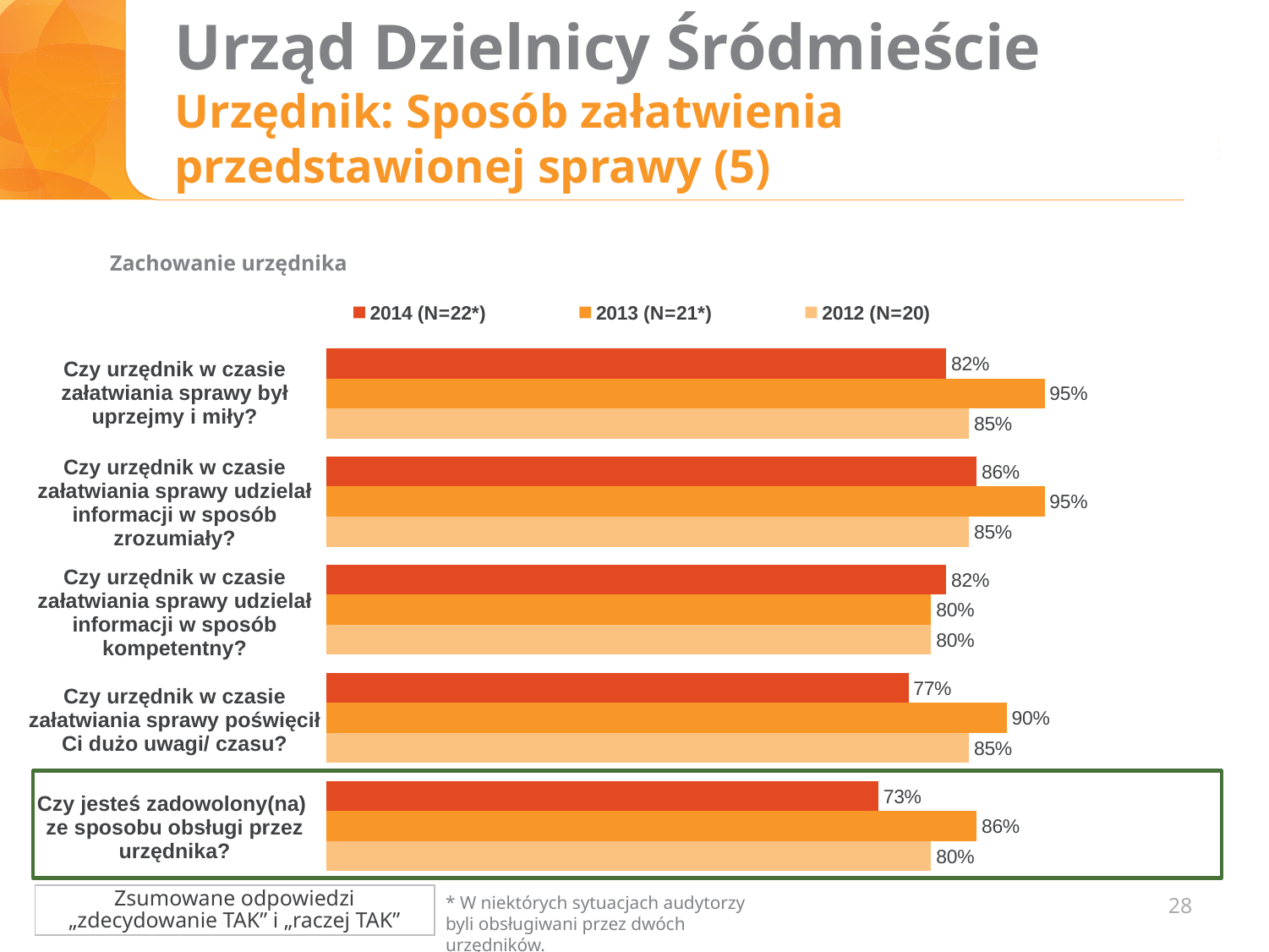
What is the 2012 (N=20) value for "Czy jesteś zadowolony(na) ze sposobu obsługi przez urzędnika?"? 80% Which question has the highest 2014 (N=22*) value? Czy urzędnik w czasie załatwiania sprawy udzielał informacji w sposób zrozumiały? What is the 2014 (N=22*) value for "Czy urzędnik w czasie załatwiania sprawy był uprzejmy i miły?"? 82% How many series does the legend list? 3 What is the 2013 (N=21*) value for "Czy urzędnik w czasie załatwiania sprawy poświęcił Ci dużo uwagi/ czasu?"? 90% Which question has the lowest 2014 (N=22*) value? Czy jesteś zadowolony(na) ze sposobu obsługi przez urzędnika? What type of chart is shown on the slide? Bar chart How many questions (categories) are shown in the chart? 5 What is the difference between the 2013 (N=21*) and 2012 (N=20) values for "Czy urzędnik w czasie załatwiania sprawy był uprzejmy i miły?"? 10% What is the title of the chart? Zachowanie urzędnika For "Czy urzędnik w czasie załatwiania sprawy udzielał informacji w sposób kompetentny?", which is larger: the 2014 (N=22*) value or the 2013 (N=21*) value? 2014 (N=22*) What is the difference between the 2013 (N=21*) and 2014 (N=22*) values for "Czy jesteś zadowolony(na) ze sposobu obsługi przez urzędnika?"? 13%